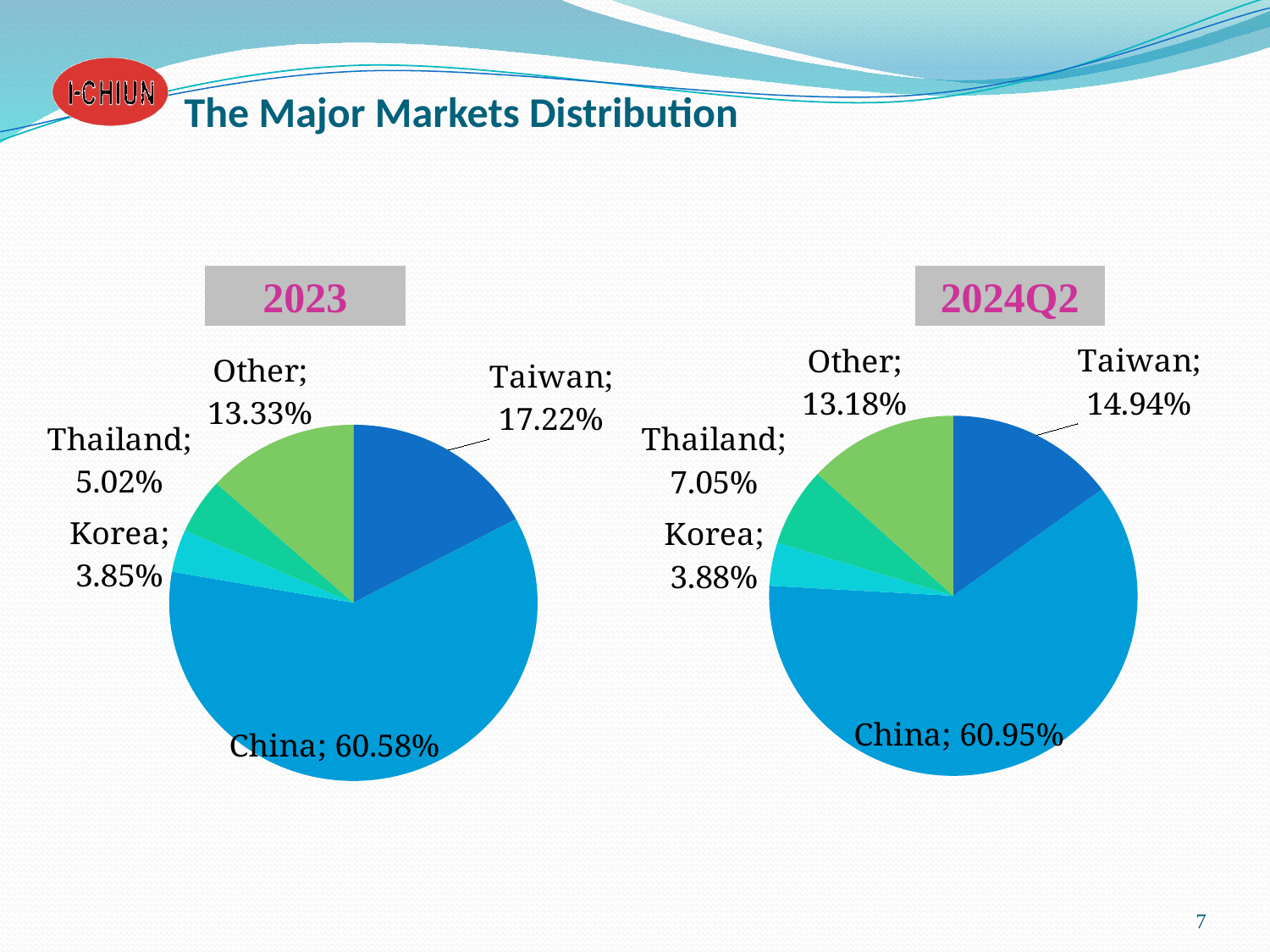
In the 2023 pie chart, what is the difference between Taiwan's share and Other's share? 3.89% What is the difference between China's share in 2024Q2 and China's share in 2023? 0.37% In the 2024Q2 pie chart, which market has the smallest share? Korea What is the title of the slide containing the two pie charts? The Major Markets Distribution In the 2024Q2 pie chart, which is larger, Thailand's share or Korea's share? Thailand In the 2023 pie chart, which market has the largest share? China How many slices does the 2023 pie chart have? 5 In the 2023 pie chart, what share does Thailand have? 5.02% What type of chart is used for the 2024Q2 data? Pie chart In the 2023 pie chart, what share does China have? 60.58% In the 2024Q2 pie chart, what share does Taiwan have? 14.94% In the 2024Q2 pie chart, what share does Korea have? 3.88%